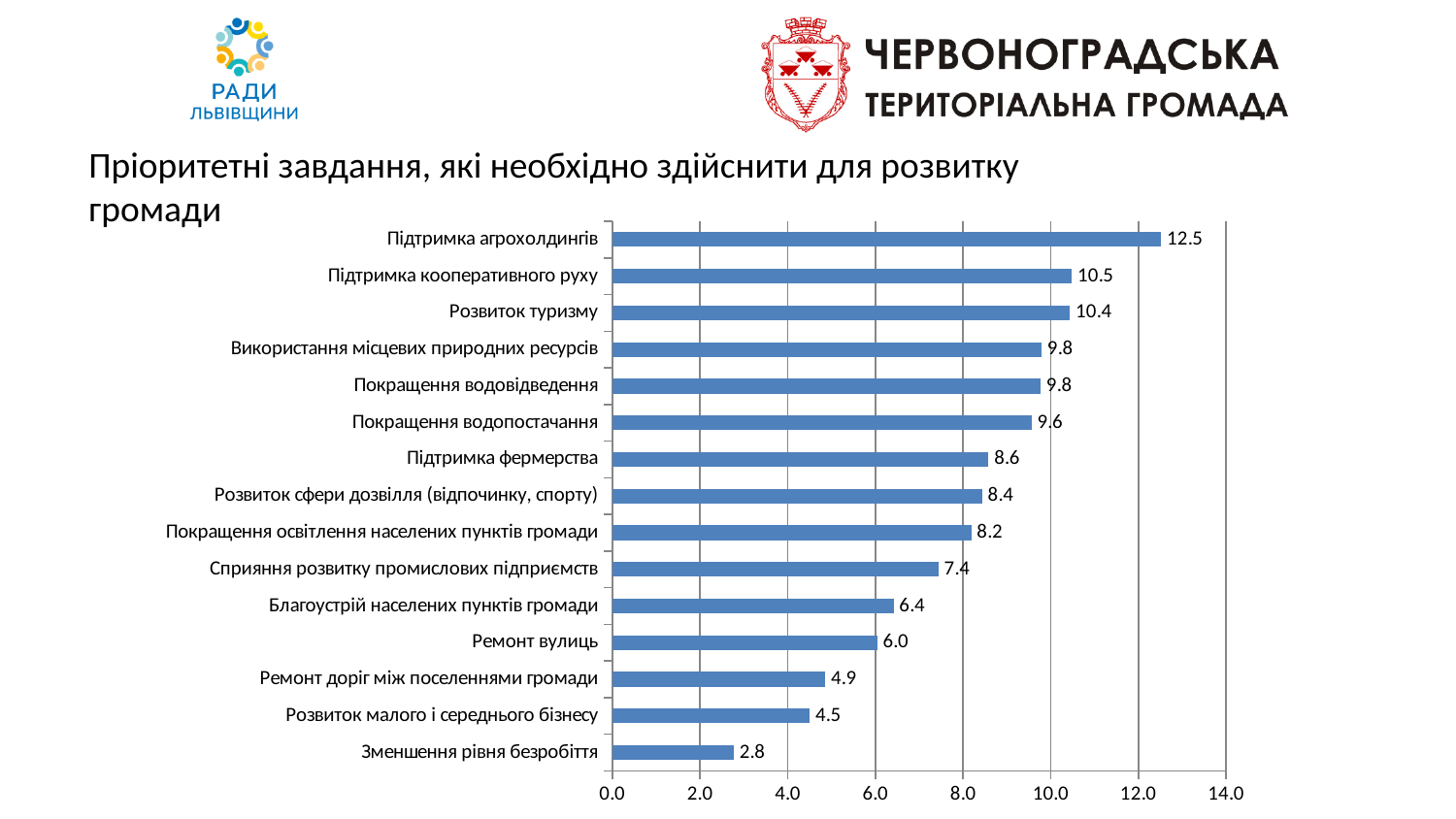
What is the value for "Підтримка агрохолдингів"? 12.5 Which category has the lowest value? Зменшення рівня безробіття What is the value for "Зменшення рівня безробіття"? 2.8 Is the value for "Підтримка фермерства" greater or less than 8.0? greater What is the value for "Ремонт вулиць"? 6.0 How many categories are shown in the chart? 15 What is the value for "Розвиток туризму"? 10.4 What is the title of the slide above the chart? Пріоритетні завдання, які необхідно здійснити для розвитку громади What is the difference between the values for "Підтримка агрохолдингів" and "Зменшення рівня безробіття"? 9.7 What type of chart is shown on the slide? Bar chart Which category has the highest value? Підтримка агрохолдингів Which is larger: the value for "Благоустрій населених пунктів громади" or the value for "Ремонт вулиць"? Благоустрій населених пунктів громади